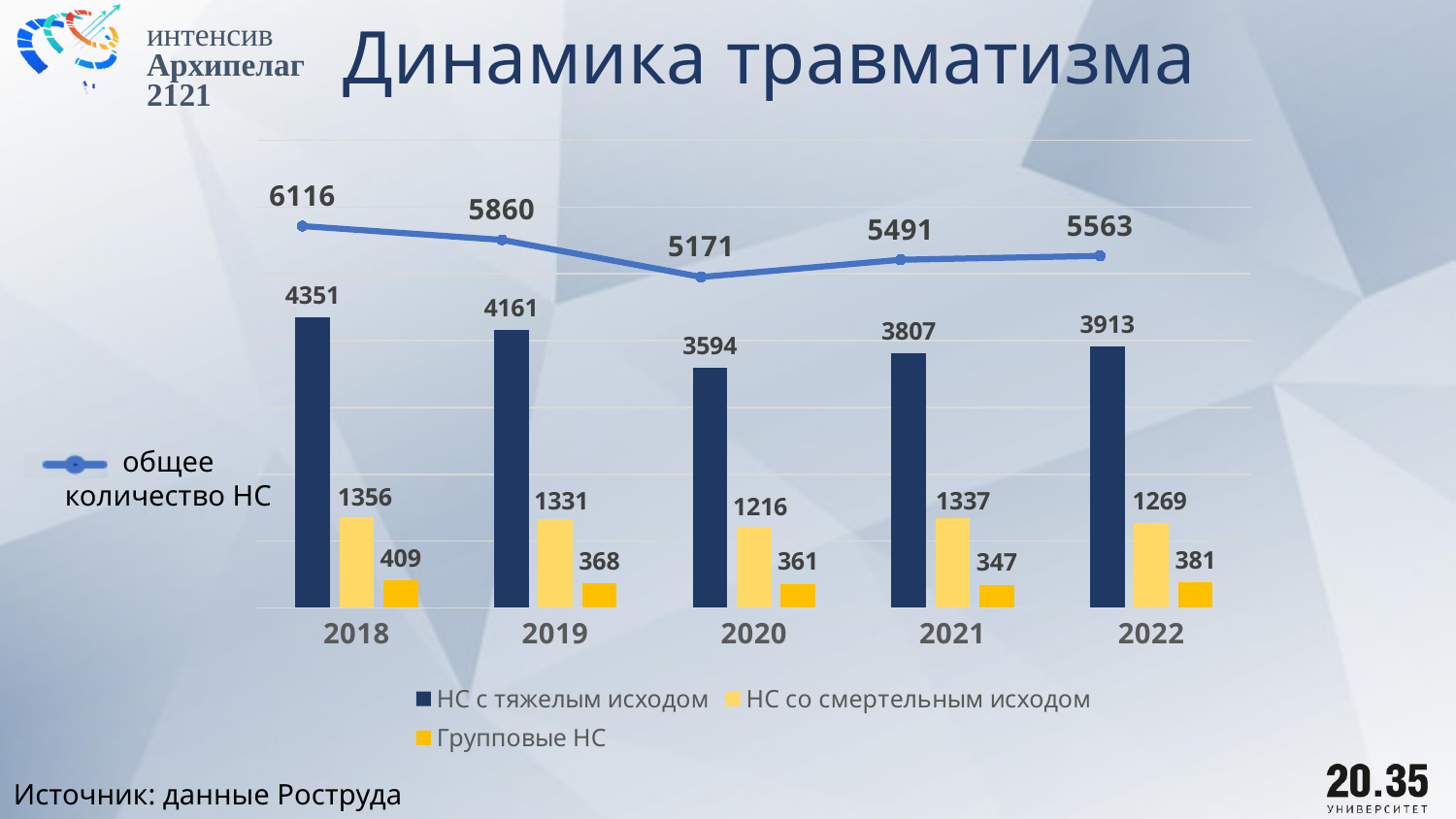
What is the value for 'Групповые НС' in 2022? 381 What is the title of the chart? Динамика травматизма What is the difference between the 'общее количество НС' values for 2018 and 2019? 256 Which is larger: 'Групповые НС' in 2018 or in 2021? 2018 In which year is the value for 'НС с тяжелым исходом' highest? 2018 What is the value for 'НС с тяжелым исходом' in 2020? 3594 What is the value for 'НС со смертельным исходом' in 2021? 1337 How many series does the legend at the bottom of the chart list? 3 How many years are shown on the x axis? 5 Does the 'общее количество НС' line rise or fall from 2018 to 2020? fall What is the value of the line series 'общее количество НС' for 2018? 6116 In which year is the total number of НС (the line series) lowest? 2020